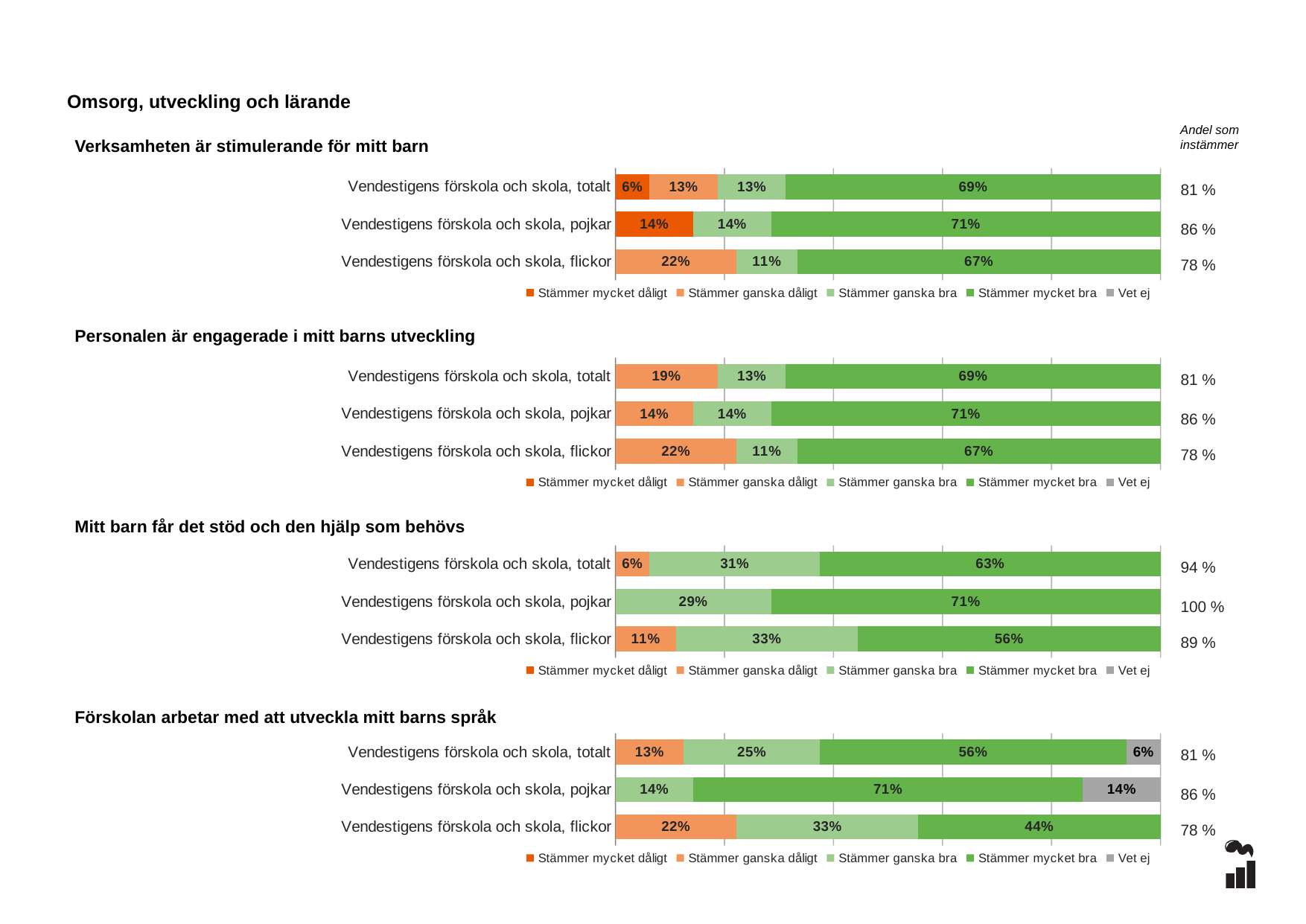
In the chart 'Mitt barn får det stöd och den hjälp som behövs', what is the difference between the 'Stämmer mycket bra' values for pojkar and flickor? 15% In the chart 'Mitt barn får det stöd och den hjälp som behövs', which category has the lowest 'Stämmer mycket bra' value? Vendestigens förskola och skola, flickor How many categories (bars) does the chart 'Förskolan arbetar med att utveckla mitt barns språk' show? 3 In the chart 'Personalen är engagerade i mitt barns utveckling', what is the 'Stämmer ganska dåligt' value for 'Vendestigens förskola och skola, totalt'? 19% In the chart 'Förskolan arbetar med att utveckla mitt barns språk', is the 'Stämmer mycket bra' value larger for totalt or for flickor? totalt What kind of chart is 'Personalen är engagerade i mitt barns utveckling'? Stacked bar chart In the chart 'Verksamheten är stimulerande för mitt barn', what is the 'Stämmer ganska dåligt' value for 'Vendestigens förskola och skola, flickor'? 22% In the chart 'Mitt barn får det stöd och den hjälp som behövs', what is the 'Stämmer ganska bra' value for 'Vendestigens förskola och skola, pojkar'? 29% In the chart 'Förskolan arbetar med att utveckla mitt barns språk', what is the 'Vet ej' value for 'Vendestigens förskola och skola, pojkar'? 14% In the chart 'Personalen är engagerade i mitt barns utveckling', which category has the highest 'Stämmer mycket bra' value? Vendestigens förskola och skola, pojkar How many series does the legend of the chart 'Verksamheten är stimulerande för mitt barn' list? 5 In the chart 'Verksamheten är stimulerande för mitt barn', what is the 'Stämmer mycket bra' value for 'Vendestigens förskola och skola, totalt'? 69%